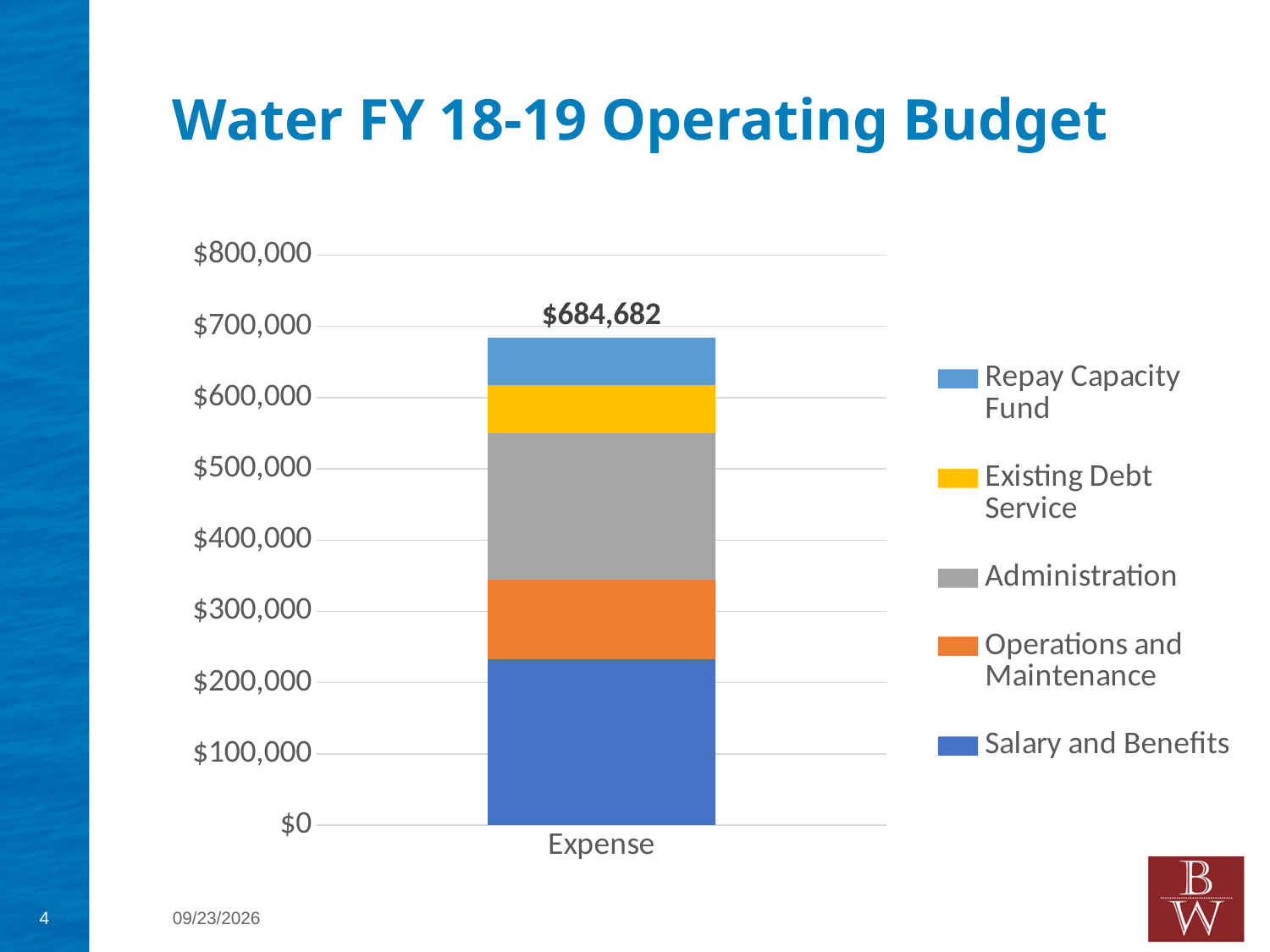
Is the value of the Salary and Benefits segment greater or less than $200,000? greater How many categories are shown on the x axis? 1 Which segment is larger, Administration or Operations and Maintenance? Administration How many series does the legend list? 5 Is the value of the Salary and Benefits segment greater or less than $300,000? less Which series is shown at the bottom of the stacked bar? Salary and Benefits Which segment is larger, Salary and Benefits or Existing Debt Service? Salary and Benefits What kind of chart is shown on the slide? Stacked bar chart What is the total value printed on the stacked bar for Expense? $684,682 Is the value of the Administration segment greater or less than $100,000? greater What is the title of the slide containing the chart? Water FY 18-19 Operating Budget